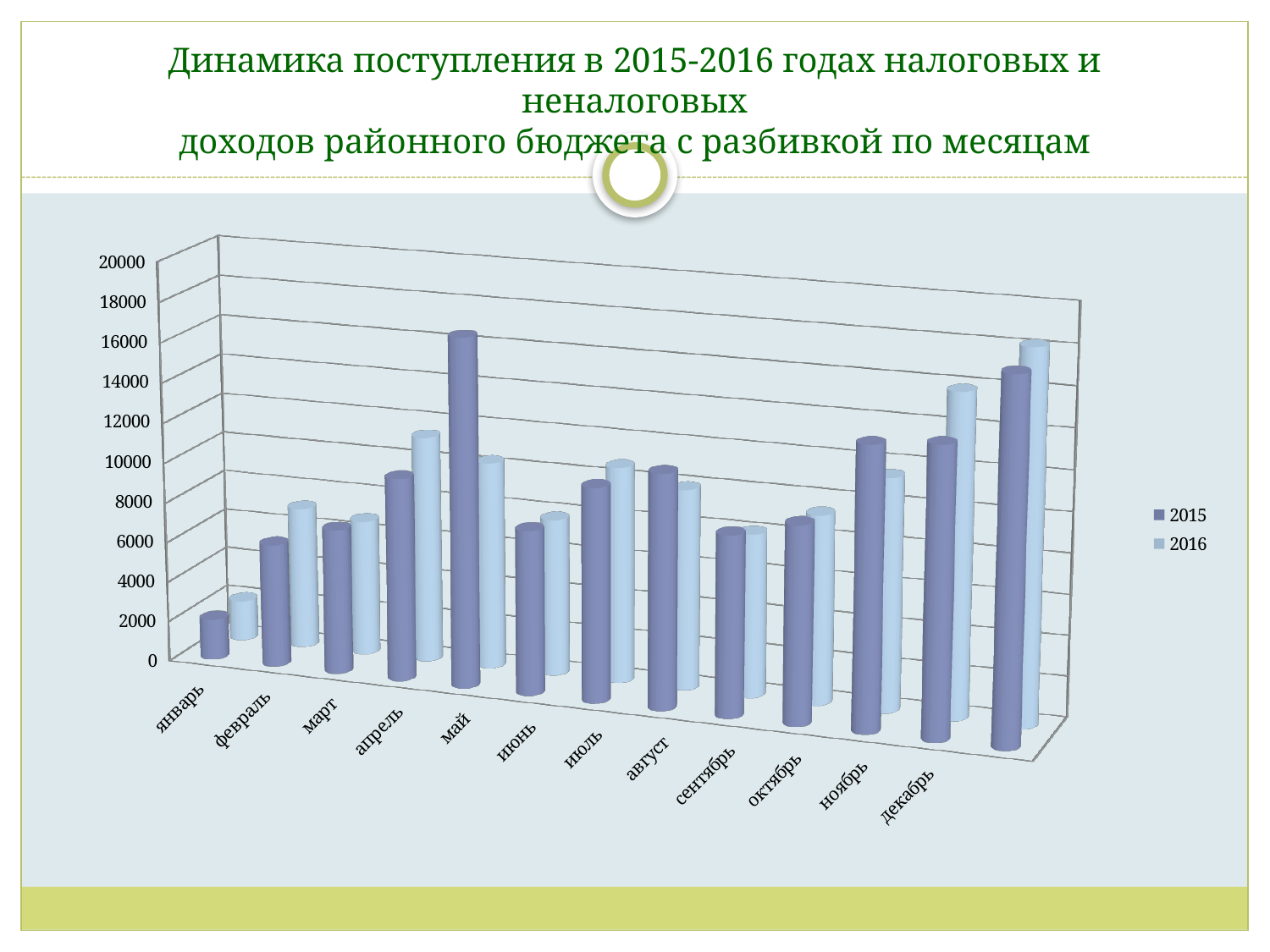
For апрель, which series has the larger value, 2015 or 2016? 2016 Which month has the lowest value for the 2016 series? январь How many series does the legend list? 2 What are the two entries listed in the chart legend? 2015 and 2016 Is the value for май in the 2015 series greater or less than 14000? greater Is the value for январь in the 2015 series greater or less than 4000? less How many months (categories) are shown on the x axis? 12 What kind of chart is shown on the slide? bar chart Which month has the highest value for the 2015 series? май Which month has the highest value for the 2016 series? декабрь For май, which series has the larger value, 2015 or 2016? 2015 Which month has the lowest value for the 2015 series? январь